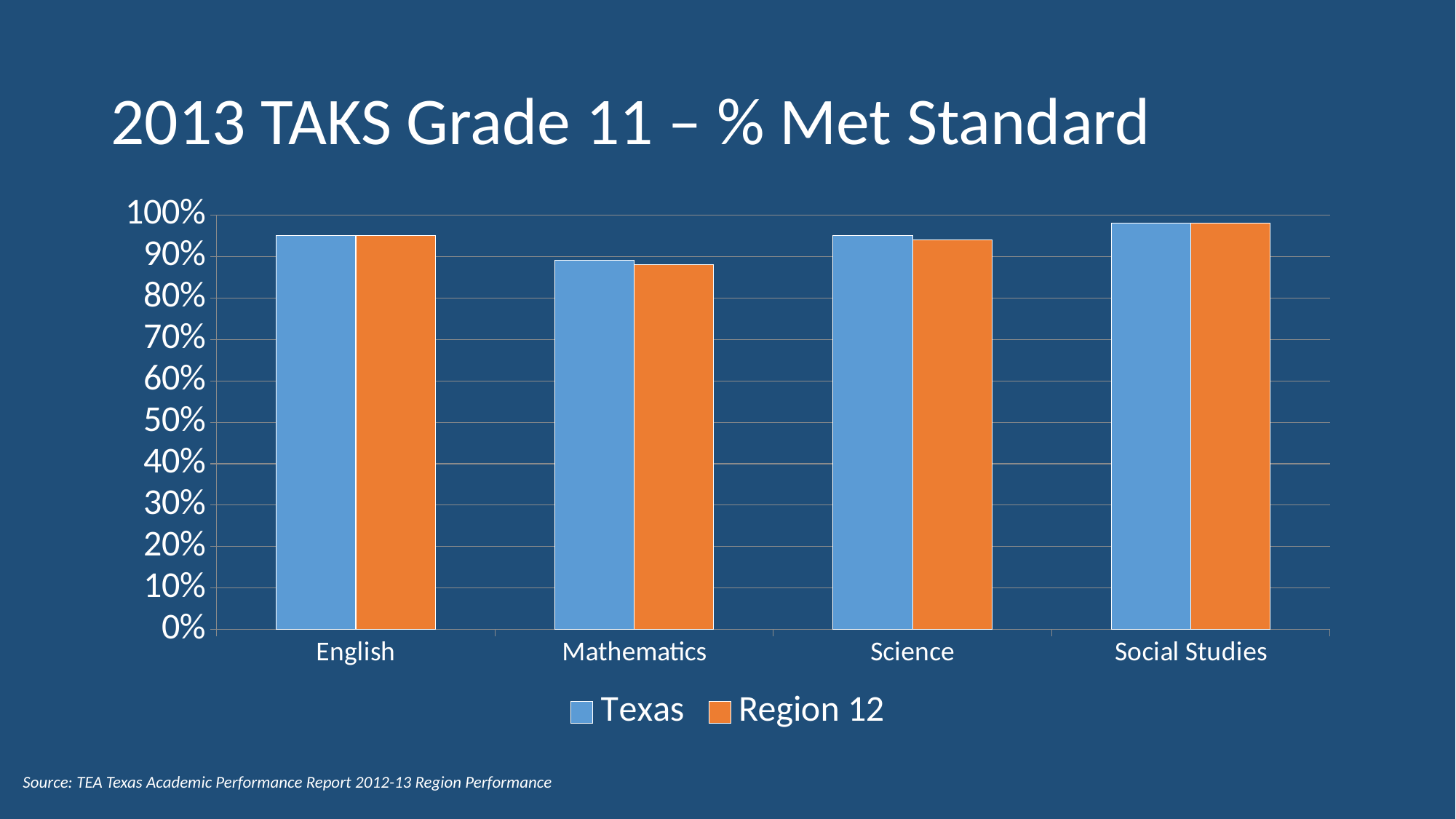
For Texas, which is larger: the value for Social Studies or the value for Mathematics? Social Studies Is the Region 12 value for Social Studies greater or less than 90%? greater Which subject has the highest value for Region 12? Social Studies Is the Region 12 value for Mathematics greater or less than 80%? greater Which subject has the lowest value for Region 12? Mathematics How many series does the legend list? 2 How many subject categories are shown on the x axis? 4 Which two series are listed in the legend? Texas and Region 12 What kind of chart is shown on the slide? bar chart What is the title of the chart? 2013 TAKS Grade 11 – % Met Standard Which subject has the lowest value for Texas? Mathematics